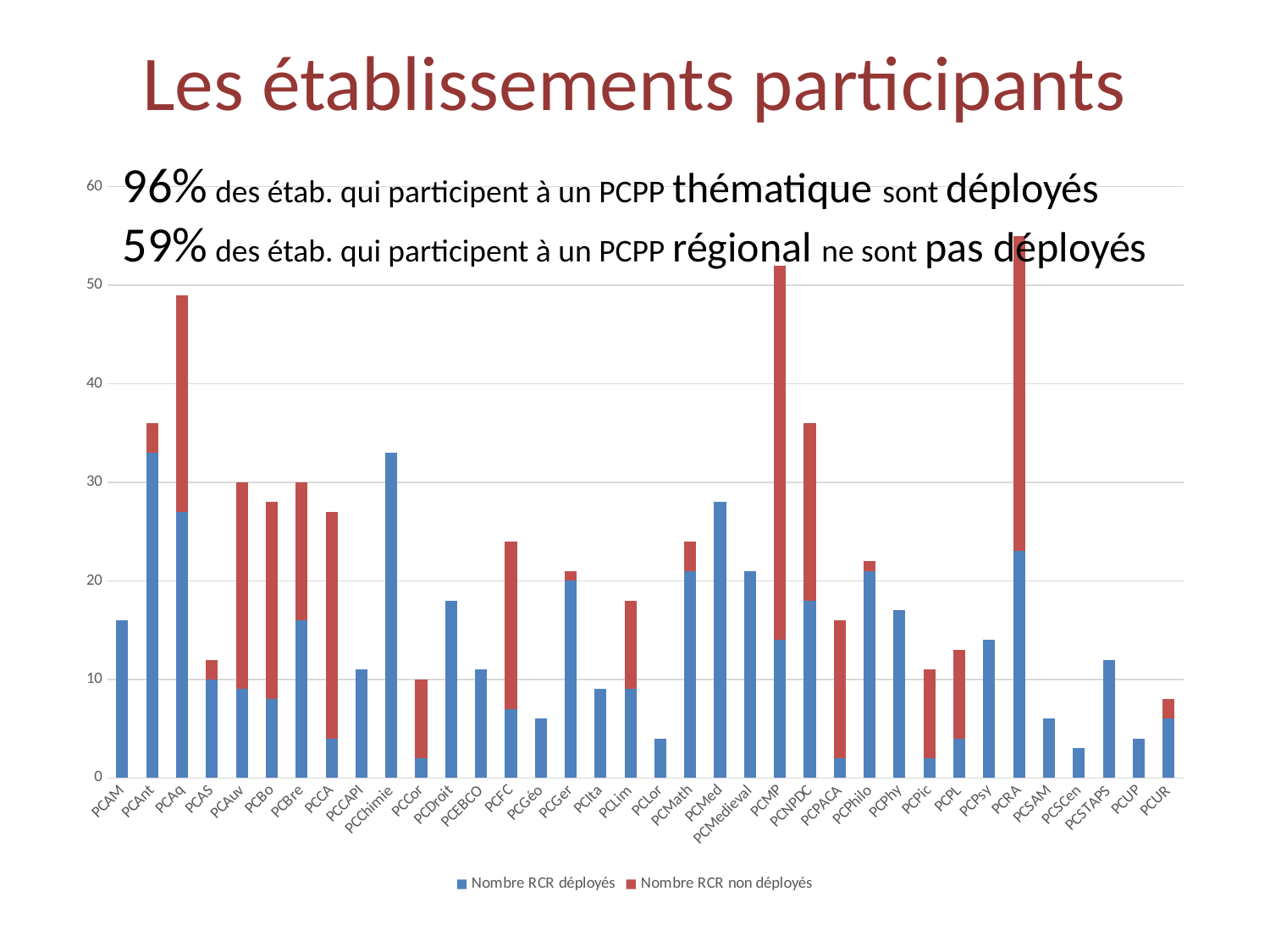
Is the value for PCSCen greater or less than 10? less Is the total value for PCAq greater or less than 40? greater Which has the larger bar, PCMed or PCMedieval? PCMed Which has the larger total bar, PCAq or PCAS? PCAq How many series does the legend list? 2 What is the title of the slide containing the chart? Les établissements participants What kind of chart is shown on the slide? Stacked bar chart Is the value for PCChimie greater or less than 30? greater How many categories (établissements) are shown on the x axis? 36 Which series is shown in red? Nombre RCR non déployés